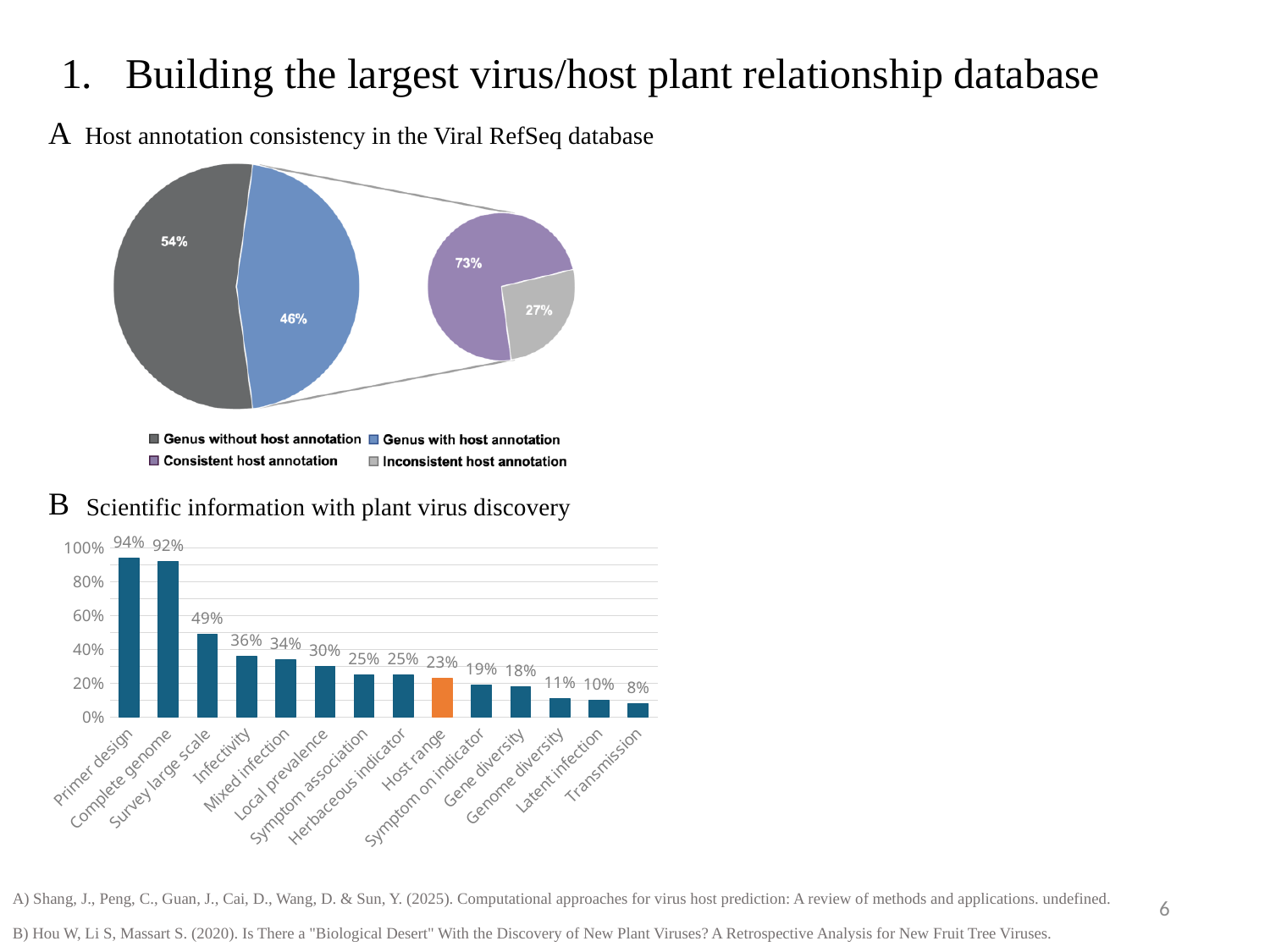
In chart B, which category has the highest value? Primer design In chart B, which category has the lowest value? Transmission In chart B, how many categories are shown on the x axis? 14 In chart A, what is the difference between 'Consistent host annotation' and 'Inconsistent host annotation'? 46% What kind of chart is chart A? Pie chart In chart A (Host annotation consistency in the Viral RefSeq database), what share of the pie is 'Genus without host annotation'? 54% In chart B, do the values rise or fall from left to right along the x axis? Fall In chart B (Scientific information with plant virus discovery), what is the value for 'Primer design'? 94% In chart A, what percentage is 'Inconsistent host annotation'? 27% In chart B, what is the difference between 'Survey large scale' and 'Host range'? 26% In chart A, what percentage is 'Consistent host annotation'? 73% In chart A, what percentage is labelled 'Genus with host annotation'? 46%